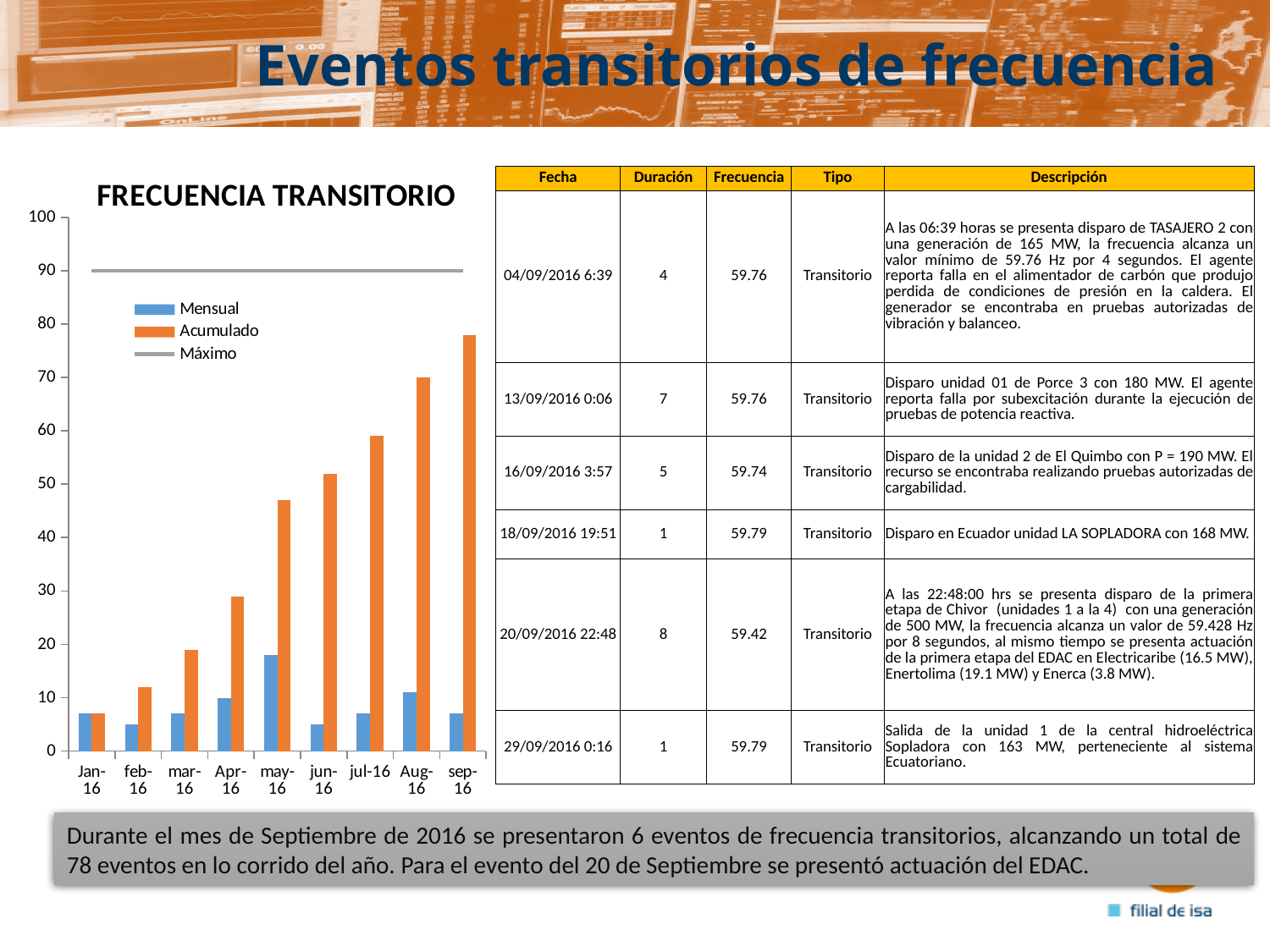
In the FRECUENCIA TRANSITORIO chart, is the Acumulado value for Jan-16 greater or less than 10? less How many series does the legend of the FRECUENCIA TRANSITORIO chart list? 3 In the FRECUENCIA TRANSITORIO chart, do the Acumulado values rise or fall from Jan-16 to sep-16? rise In the FRECUENCIA TRANSITORIO chart, is the Máximo line greater or less than 80? greater In the FRECUENCIA TRANSITORIO chart, is the Mensual value for may-16 greater or less than 10? greater What kind of chart is the FRECUENCIA TRANSITORIO chart? bar chart In the FRECUENCIA TRANSITORIO chart, which is larger for sep-16, the Mensual value or the Acumulado value? Acumulado In the FRECUENCIA TRANSITORIO chart, which month has the highest Acumulado value? sep-16 What is the title of the chart on the left of the slide? FRECUENCIA TRANSITORIO How many months are shown on the x axis of the FRECUENCIA TRANSITORIO chart? 9 In the FRECUENCIA TRANSITORIO chart, which month has the highest Mensual value? may-16